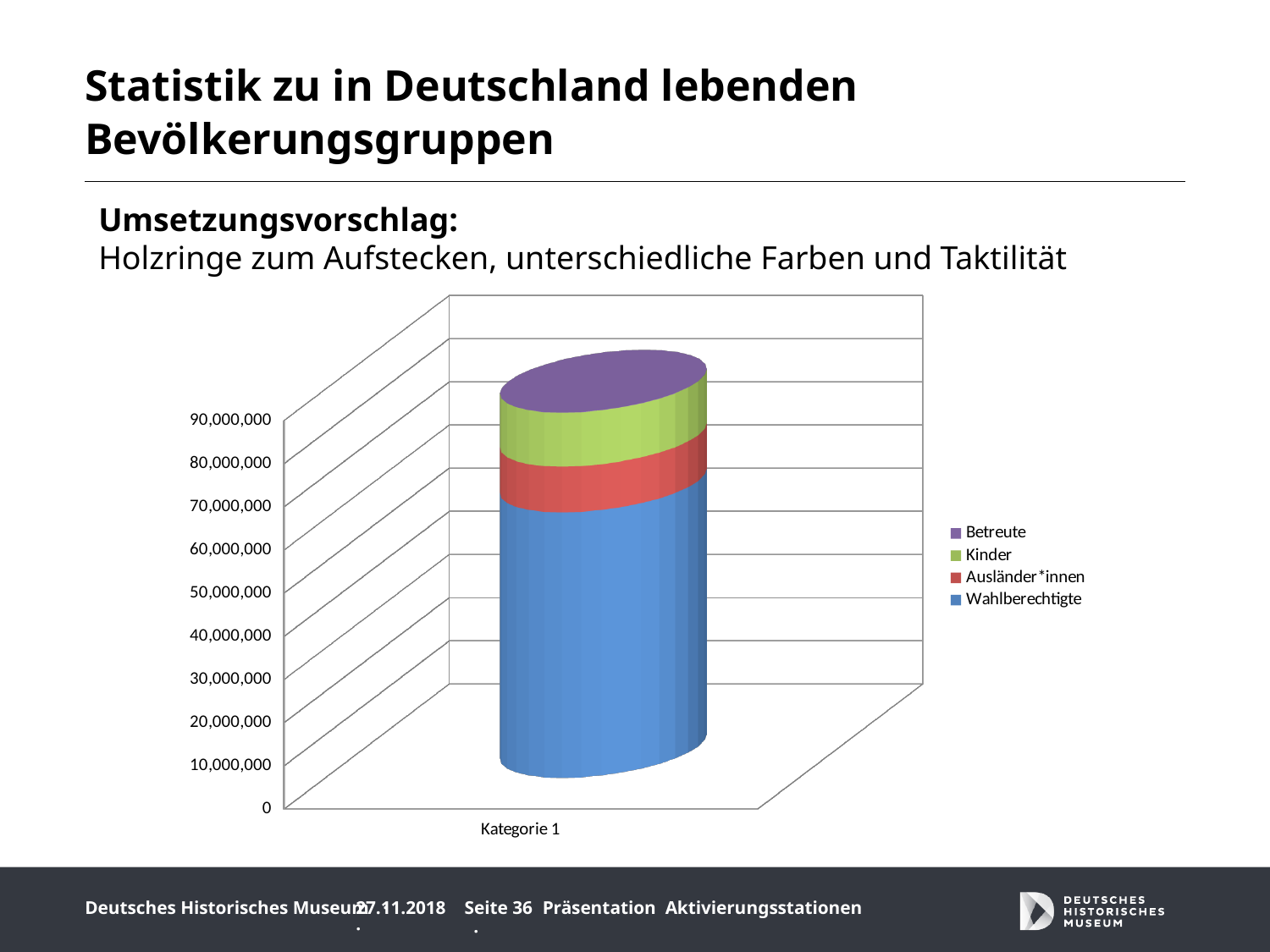
Which series is at the bottom of the stacked bar? Wahlberechtigte Which series is at the top of the stacked bar? Betreute What is the label of the single category on the x axis? Kategorie 1 Which segment is larger in the stacked bar, Wahlberechtigte or Ausländer*innen? Wahlberechtigte Which segment is larger in the stacked bar, Wahlberechtigte or Kinder? Wahlberechtigte What kind of chart is shown on the slide? Stacked bar chart How many series does the legend list? 4 Which series forms the largest segment of the stacked bar? Wahlberechtigte What colour represents Wahlberechtigte in the legend? Blue What is the highest value shown on the vertical axis? 90,000,000 How many categories are plotted on the x axis? 1